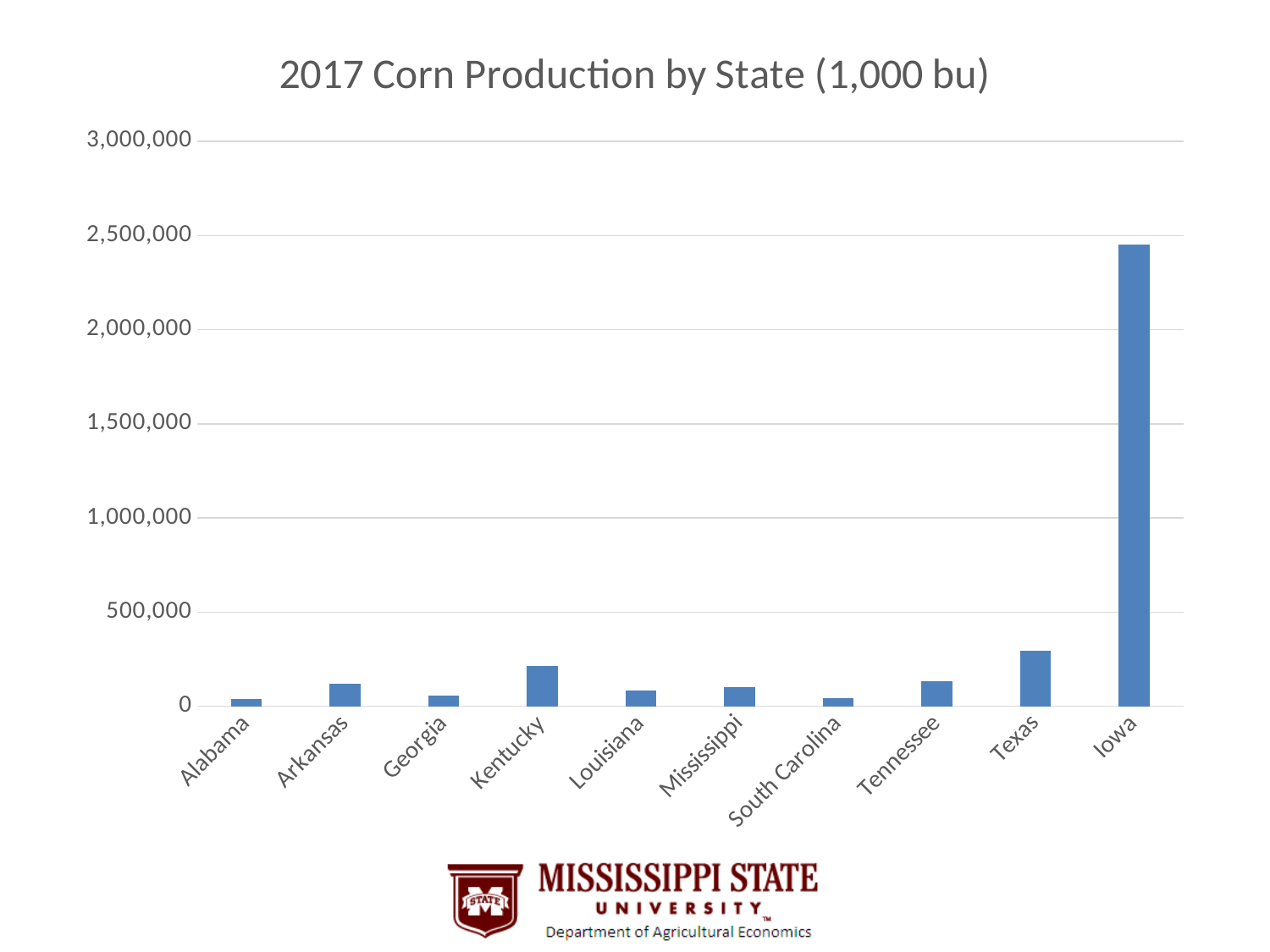
Is the value for Iowa greater or less than 2,000,000? greater Which state has the highest corn production in the chart? Iowa Is the value for Kentucky greater or less than 500,000? less What type of chart is shown on the slide? Bar chart Which has the larger value, Iowa or Texas? Iowa What is the title of the chart? 2017 Corn Production by State (1,000 bu) How many states are shown on the x axis of the chart? 10 Which has the larger value, Texas or Kentucky? Texas Is the value for Iowa greater or less than 2,500,000? less Which has the larger value, Kentucky or Georgia? Kentucky Which state is shown in the last position on the x axis? Iowa